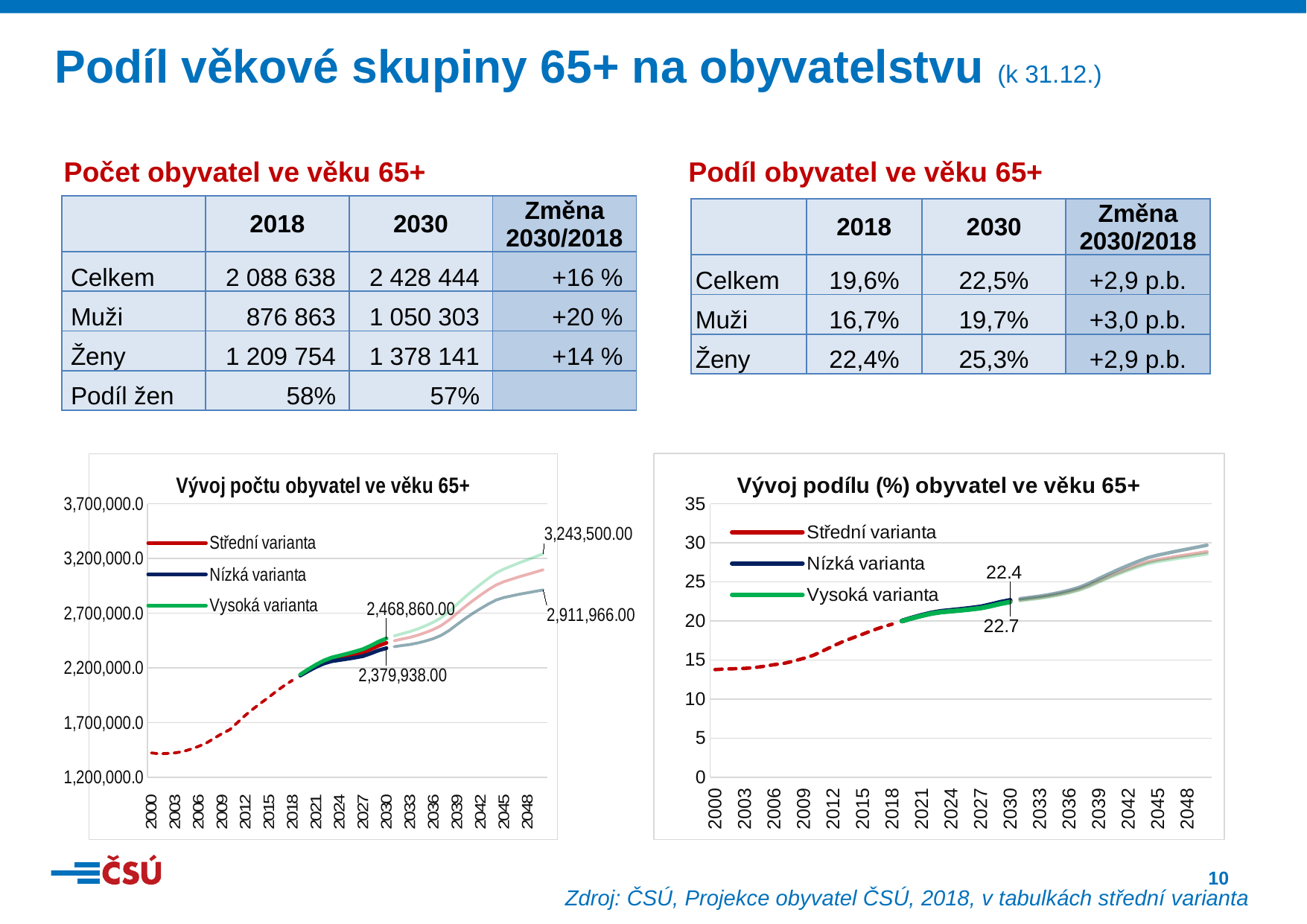
In the chart titled "Vývoj počtu obyvatel ve věku 65+", what is the difference between the two data labels shown at 2030 (2,468,860.00 and 2,379,938.00)? 88,922.00 In the chart titled "Vývoj podílu (%) obyvatel ve věku 65+", do the values rise or fall from 2000 to 2048? rise In the chart titled "Vývoj podílu (%) obyvatel ve věku 65+", what are the two data labels shown at 2030? 22.4 and 22.7 Which series is drawn in red in the chart titled "Vývoj podílu (%) obyvatel ve věku 65+"? Střední varianta In the chart titled "Vývoj podílu (%) obyvatel ve věku 65+", is the value for 2000 greater or less than 15? less In the chart titled "Vývoj podílu (%) obyvatel ve věku 65+", what is the difference between the two data labels at 2030 (22.7 and 22.4)? 0.3 In the chart titled "Vývoj počtu obyvatel ve věku 65+", what is the highest value printed as a data label? 3,243,500.00 In the chart titled "Vývoj počtu obyvatel ve věku 65+", what is the lowest value printed as a data label? 2,379,938.00 In the chart titled "Vývoj počtu obyvatel ve věku 65+", what is the difference between the two data labels shown at the right end of the lines (3,243,500.00 and 2,911,966.00)? 331,534.00 In the chart titled "Vývoj počtu obyvatel ve věku 65+", is the value for 2000 greater or less than 1,700,000.0? less How many series does the legend of the chart titled "Vývoj podílu (%) obyvatel ve věku 65+" list? 3 What kind of chart is the chart titled "Vývoj počtu obyvatel ve věku 65+"? line chart